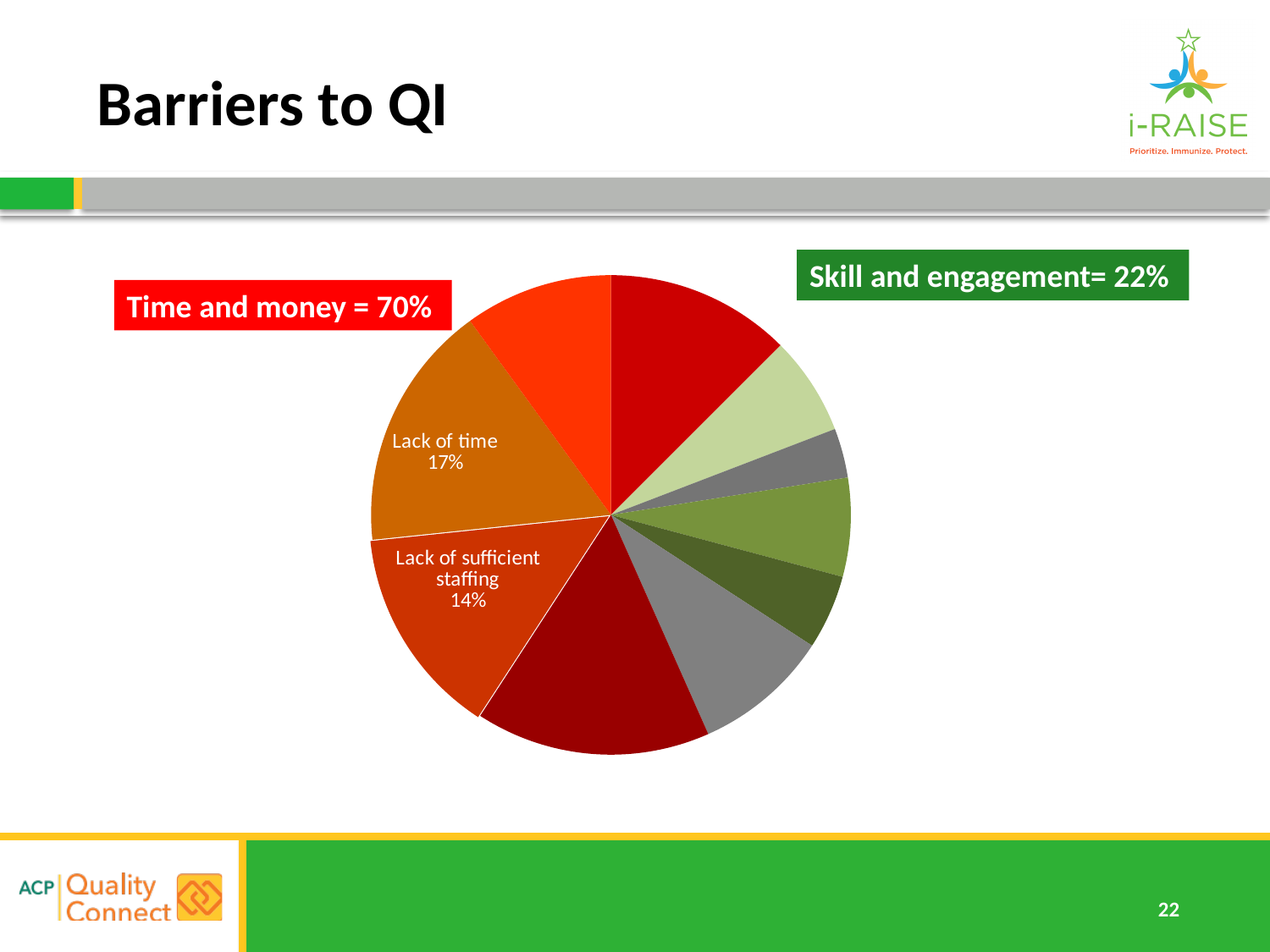
What is the title of the slide containing the pie chart? Barriers to QI How many slices does the pie chart have? 10 What kind of chart is shown on the slide? pie chart What share of the pie is labeled "Lack of sufficient staffing"? 14% Which labeled slice is larger, "Lack of time" or "Lack of sufficient staffing"? Lack of time What is the combined share of the two labeled slices, "Lack of time" and "Lack of sufficient staffing"? 31% What is the difference between the "Lack of time" share and the "Lack of sufficient staffing" share? 3% What share of the pie is labeled "Lack of time"? 17% According to the callout on the slide, what percentage is attributed to "Time and money"? 70%